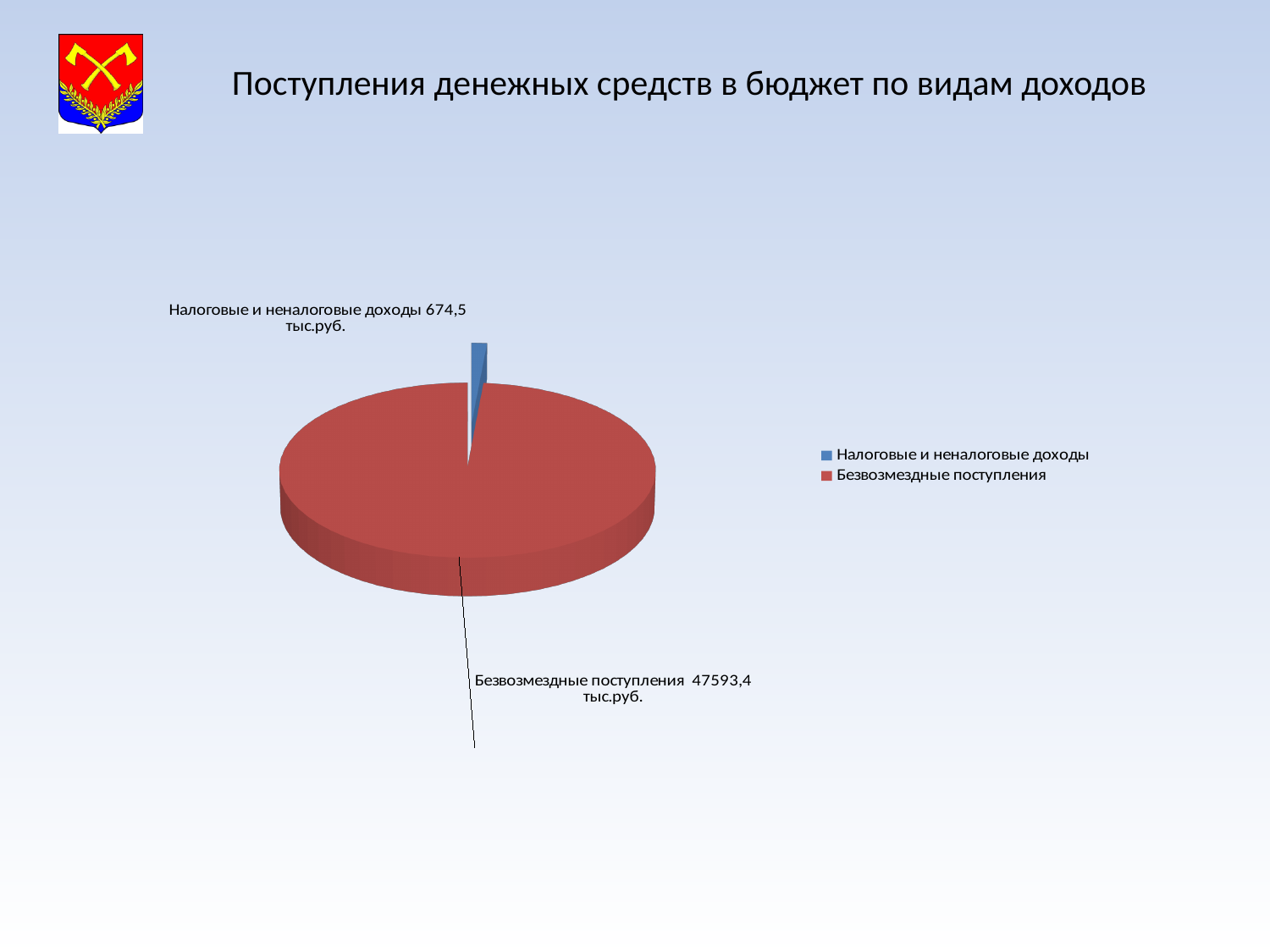
What is the title of the slide? Поступления денежных средств в бюджет по видам доходов What colour is the slice for Безвозмездные поступления? Red What kind of chart is shown on the slide? Pie chart Which category has the smallest slice of the pie? Налоговые и неналоговые доходы What is the total of the two categories shown in the pie chart? 48267,9 тыс.руб. What value is shown for Безвозмездные поступления? 47593,4 тыс.руб. How many categories does the pie chart show? 2 How many entries does the legend list? 2 What is the difference between Безвозмездные поступления and Налоговые и неналоговые доходы? 46918,9 тыс.руб. Which is larger: Налоговые и неналоговые доходы or Безвозмездные поступления? Безвозмездные поступления What value is shown for Налоговые и неналоговые доходы? 674,5 тыс.руб. Which category has the largest slice of the pie? Безвозмездные поступления